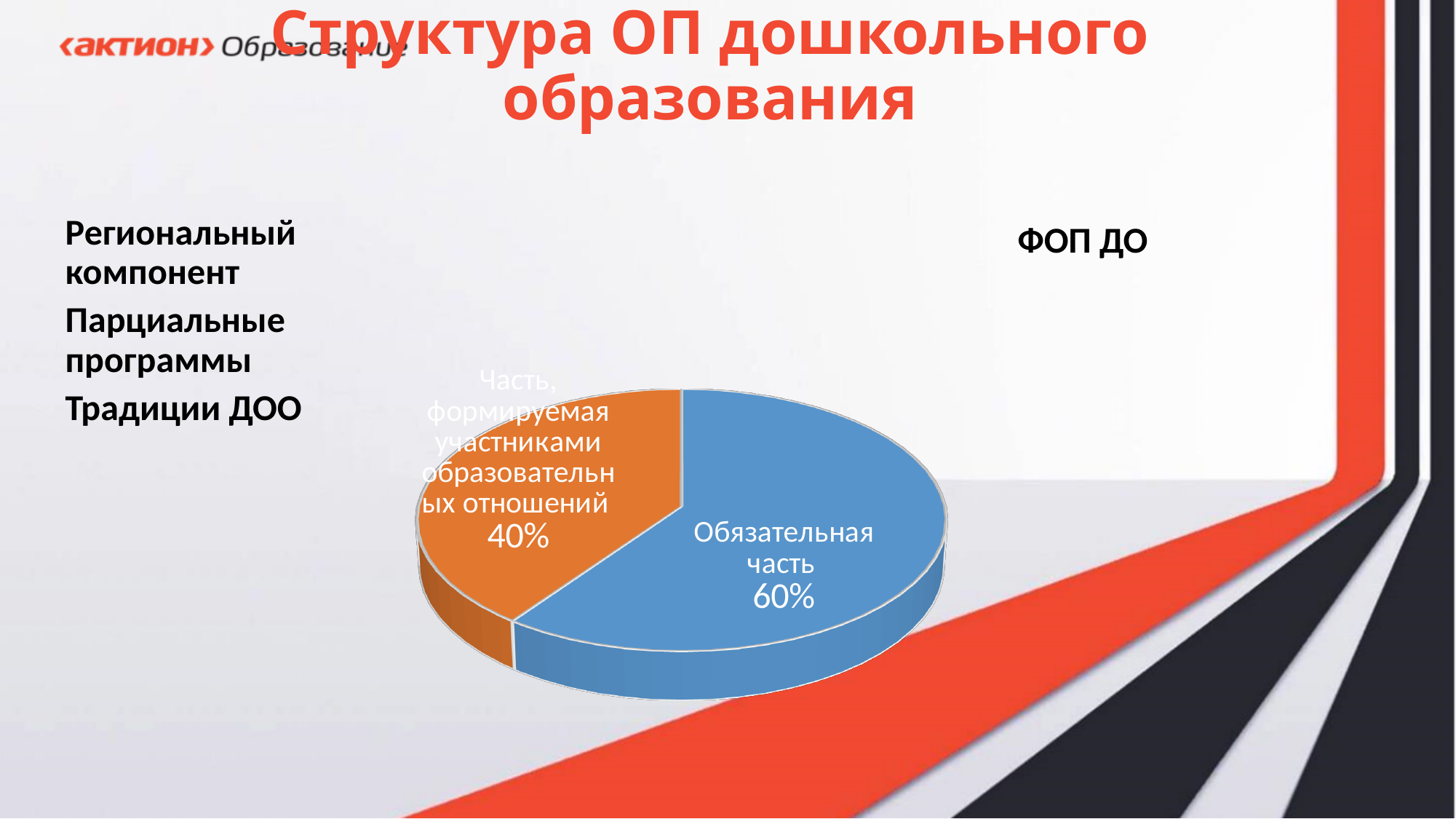
What share of the pie does "Часть, формируемая участниками образовательных отношений" take? 40% How many slices does the pie chart have? 2 Is the share for "Обязательная часть" greater or less than 50%? greater What is the difference in percentage points between "Обязательная часть" and "Часть, формируемая участниками образовательных отношений"? 20 percentage points Which slice of the pie is the largest? Обязательная часть What colour is the "Обязательная часть" slice? blue Which is larger: "Обязательная часть" or "Часть, формируемая участниками образовательных отношений"? Обязательная часть What kind of chart is shown on the slide? pie chart What colour is the "Часть, формируемая участниками образовательных отношений" slice? orange What share of the pie does "Обязательная часть" take? 60% What is the total of the two slices shown in the pie chart? 100% Which slice of the pie is the smallest? Часть, формируемая участниками образовательных отношений